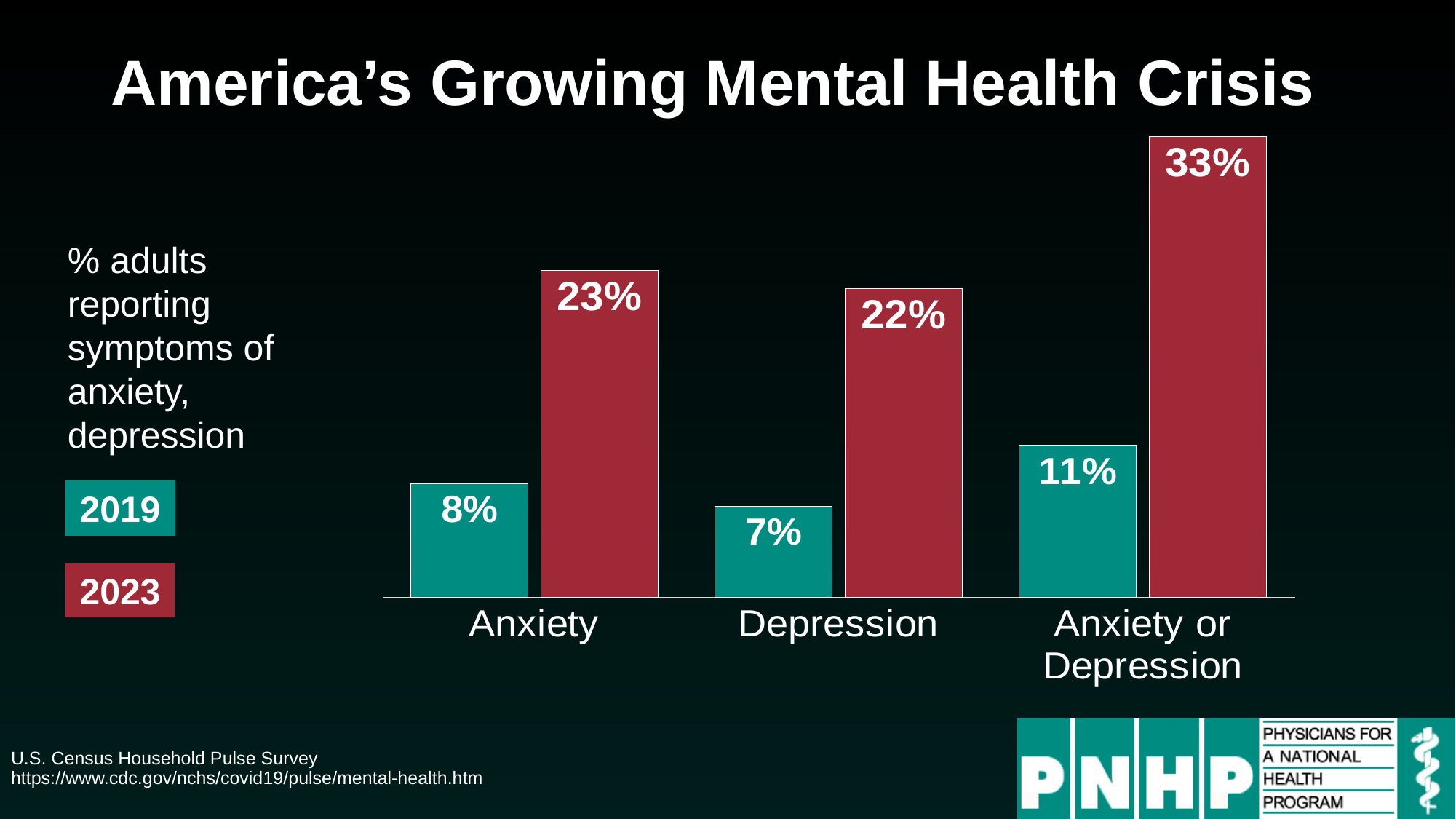
What percentage of adults reported symptoms of anxiety in 2019? 8% Which category has the lowest 2019 value? Depression What is the difference between the 2023 and 2019 values for Anxiety or Depression? 22% How many categories are shown on the x axis? 3 What is the 2019 value for Anxiety or Depression? 11% What percentage of adults reported symptoms of anxiety in 2023? 23% What kind of chart is shown on the slide? Bar chart Which category has the highest 2023 value? Anxiety or Depression What is the 2023 value for Depression? 22% What is the difference between the 2023 and 2019 values for Depression? 15% Which is larger: the 2019 value for Anxiety or the 2019 value for Depression? Anxiety How many series does the legend list? 2